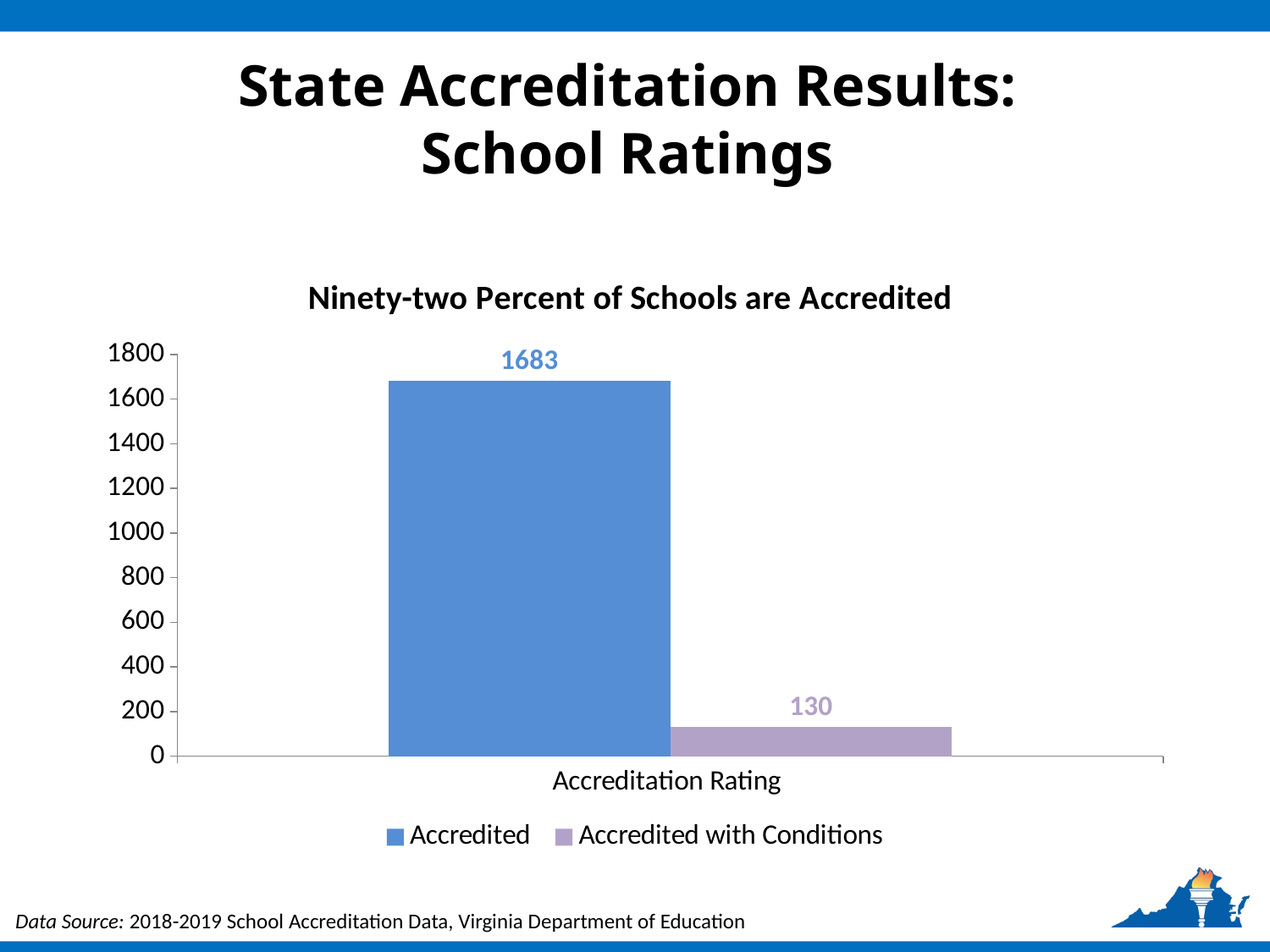
What kind of chart is shown? bar chart What is the value for Accredited with Conditions? 130 What is the title of the chart? Ninety-two Percent of Schools are Accredited Which series has the lowest value? Accredited with Conditions How many series does the legend list? 2 What is the value for Accredited? 1683 What is the difference between the Accredited and Accredited with Conditions values? 1553 Which series has the highest value? Accredited What is the label on the x axis? Accreditation Rating Is the value for Accredited with Conditions greater or less than 200? less Which is larger, Accredited or Accredited with Conditions? Accredited Is the value for Accredited greater or less than 1600? greater